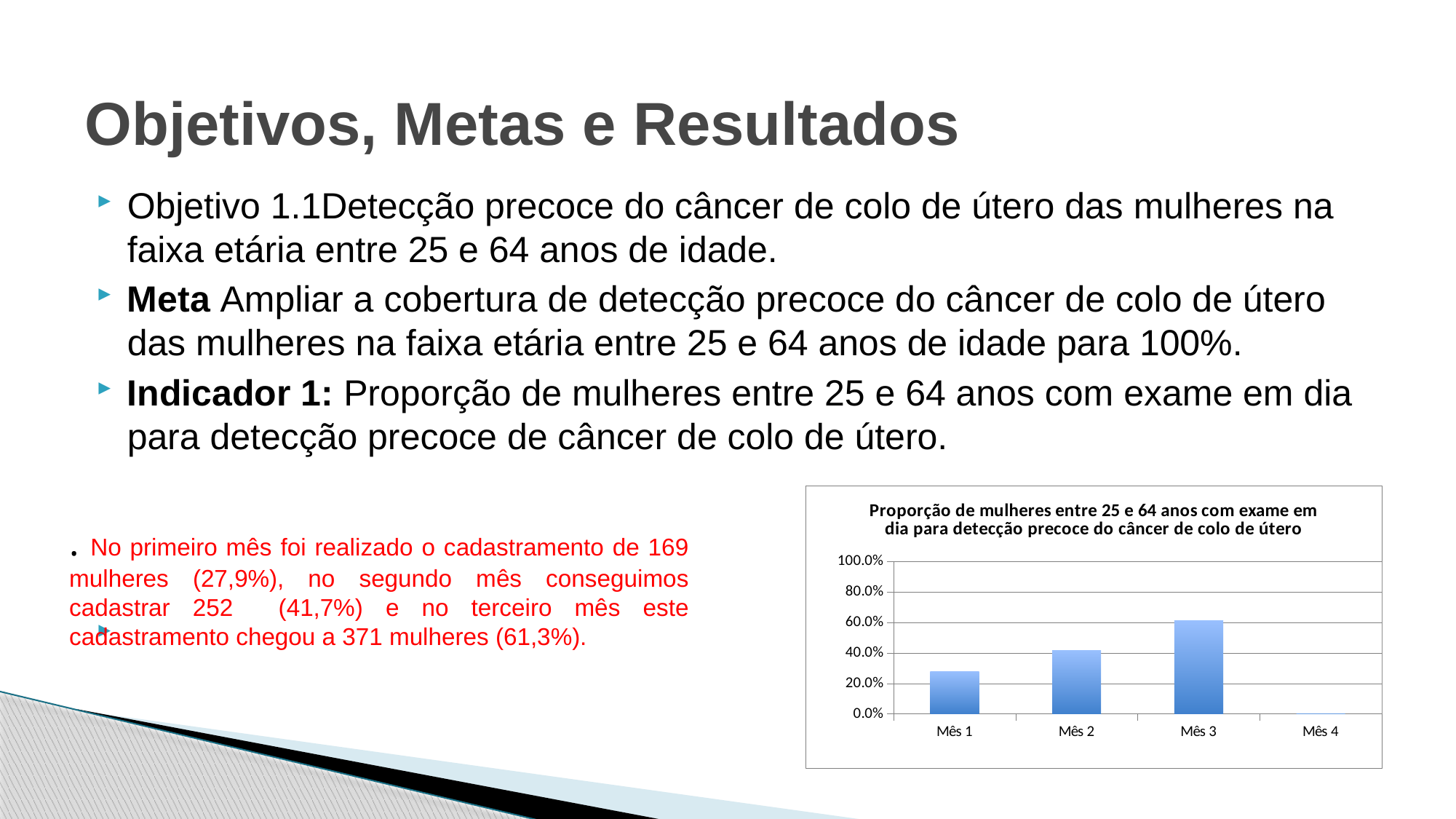
Which is larger, the value for Mês 2 or the value for Mês 3? Mês 3 Is the value for Mês 3 greater or less than 80.0%? less Which month has the lowest value in the chart? Mês 4 Which month has the highest bar in the chart? Mês 3 What kind of chart is shown on the slide? bar chart How many categories (months) are shown on the x axis of the chart? 4 Is the value for Mês 1 greater or less than 40.0%? less What is the title of the chart? Proporção de mulheres entre 25 e 64 anos com exame em dia para detecção precoce do câncer de colo de útero Do the values rise or fall from Mês 1 to Mês 3? rise What is the highest tick value shown on the chart's y axis? 100.0% Is the value for Mês 2 greater or less than 60.0%? less